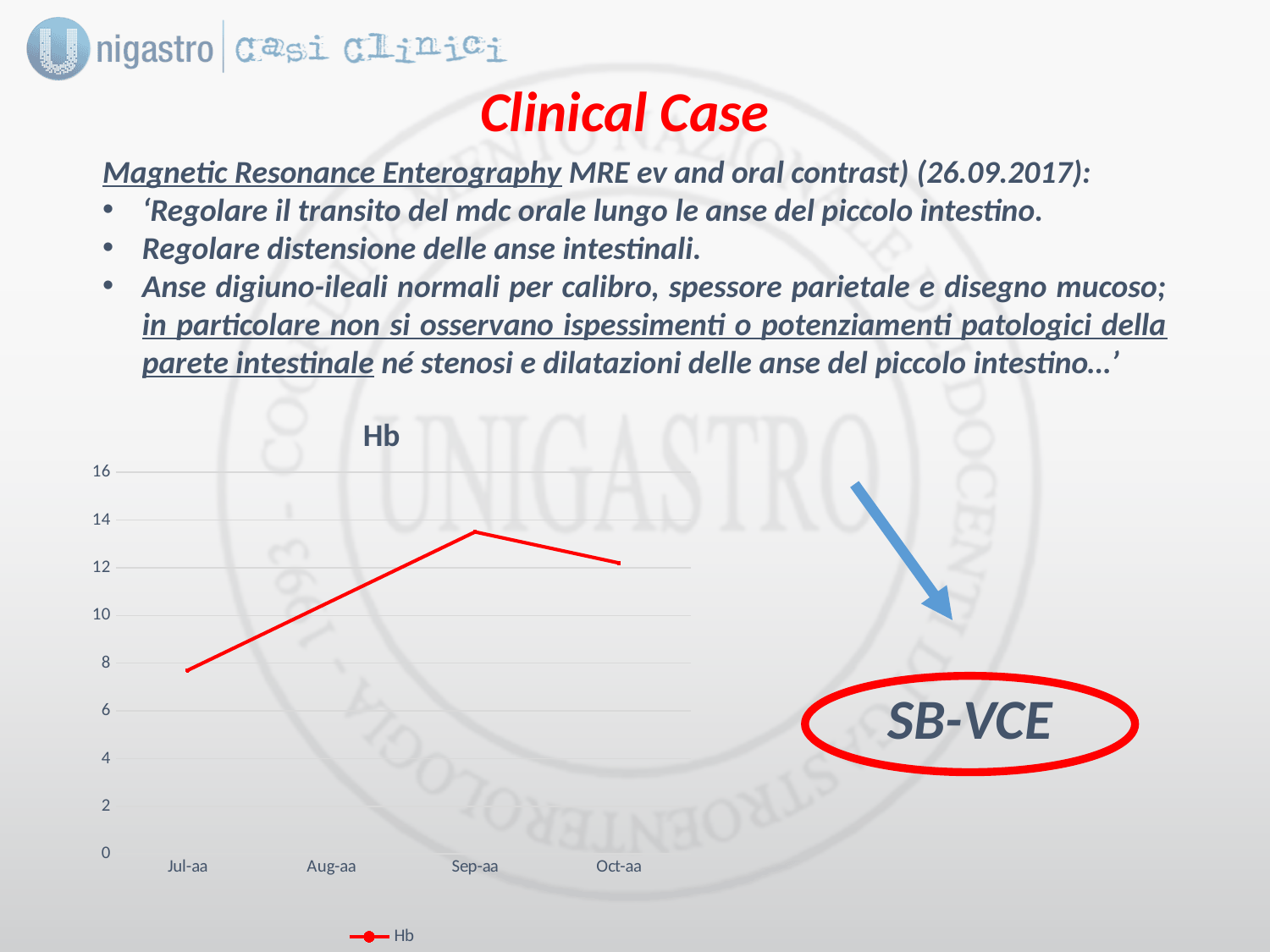
Is the Hb value for Jul-aa greater or less than 10? less Is the Hb value for Oct-aa greater or less than 10? greater How many categories are shown on the x axis of the chart? 4 Is the Hb value for Sep-aa greater or less than 12? greater Which is larger, the Hb value for Sep-aa or for Oct-aa? Sep-aa Which month has the highest Hb value? Sep-aa Does the Hb line rise or fall between Sep-aa and Oct-aa? fall What kind of chart is shown on the slide? line chart Which month has the lowest Hb value? Jul-aa What is the title of the chart? Hb How many series does the chart legend list? 1